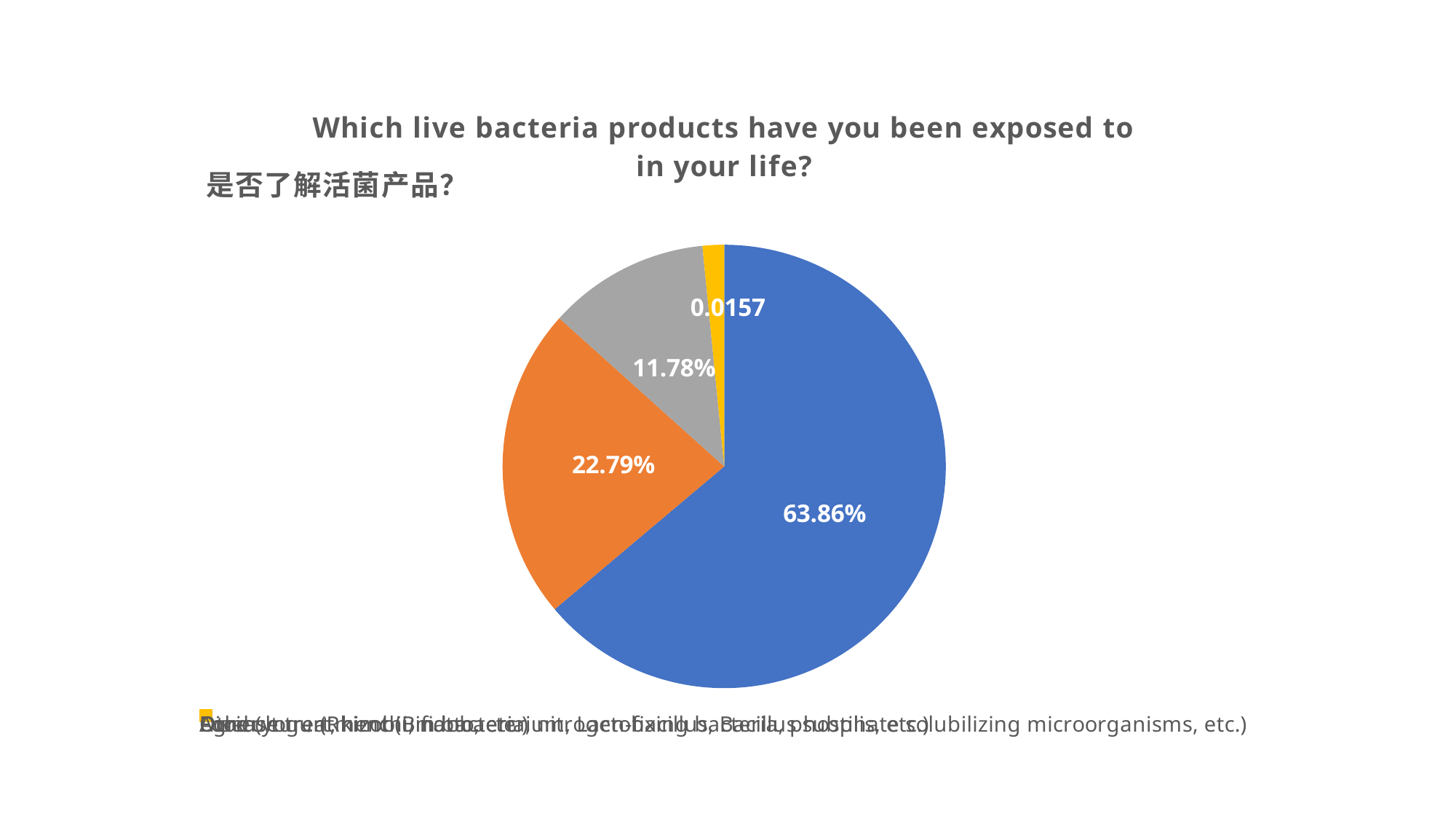
What value is labelled on the orange slice of the pie chart? 22.79% Which colour slice is the smallest in the pie chart? yellow What value is labelled on the blue slice of the pie chart? 63.86% What kind of chart is shown on the slide? pie chart What value is labelled on the yellow slice of the pie chart? 0.0157 What is the value of the largest slice in the pie chart? 63.86% How many slices does the pie chart have? 4 What is the title of the chart? Which live bacteria products have you been exposed to in your life? What is the combined share of the blue and orange slices? 86.65% What value is labelled on the grey slice of the pie chart? 11.78% Which slice is larger, the orange slice or the grey slice? orange What is the difference between the blue slice (63.86%) and the orange slice (22.79%)? 41.07%